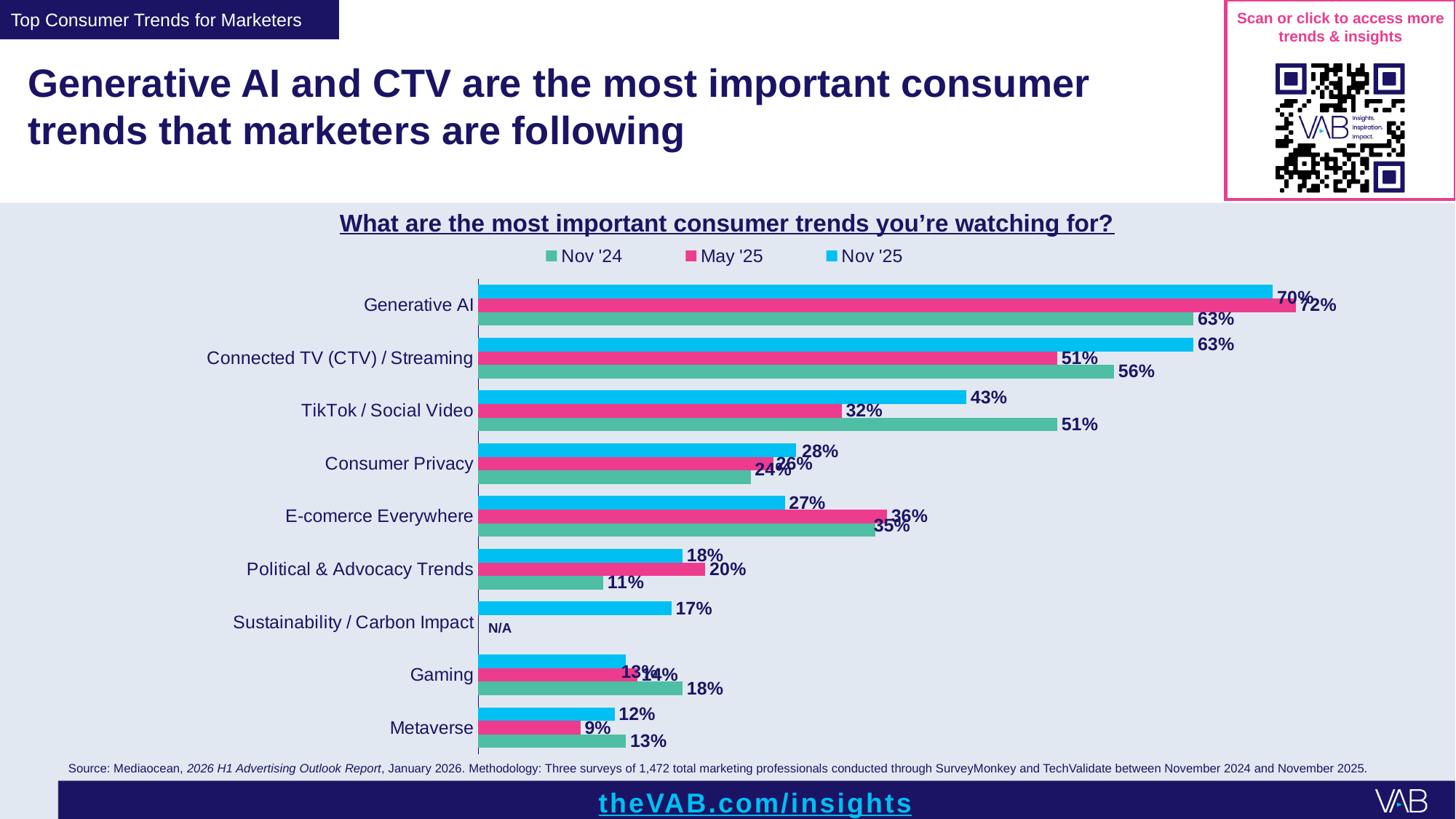
What is the Nov '24 value for TikTok / Social Video? 51% How many consumer trend categories are plotted on the chart? 9 What is the difference between the Nov '25 and May '25 values for TikTok / Social Video? 11% Which category has the lowest May '25 value? Metaverse What is the Nov '25 value for Connected TV (CTV) / Streaming? 63% What is the question shown as the chart's title? What are the most important consumer trends you're watching for? Which category has the highest Nov '25 value? Generative AI How many series does the legend list? 3 What kind of chart is shown on the slide? bar chart For Political & Advocacy Trends, which is larger: the May '25 value or the Nov '24 value? May '25 What value is shown for Sustainability / Carbon Impact in Nov '25? 17% What is the May '25 value for Generative AI? 72%